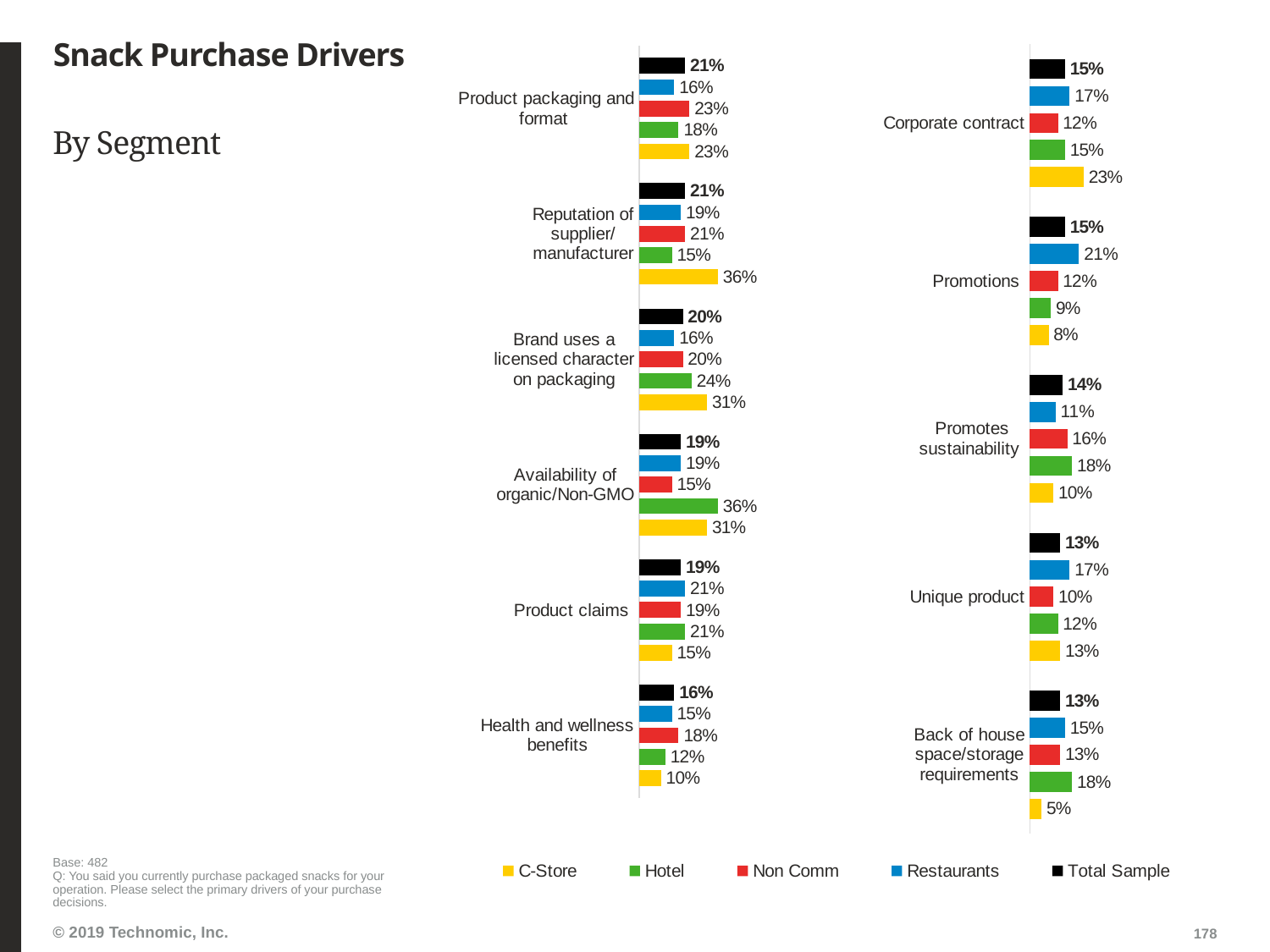
In the right chart, which is larger for Promotes sustainability: the Hotel value or the Restaurants value? Hotel How many categories are shown in the left chart? 6 In the left chart, what is the difference between the C-Store and Hotel values for Brand uses a licensed character on packaging? 7% In the right chart, what is the Restaurants value for Promotions? 21% How many categories are shown in the right chart? 5 In the left chart, what is the Hotel value for Availability of organic/Non-GMO? 36% In the left chart, which segment has the lowest value for Health and wellness benefits? C-Store What type of chart is used on this slide? Bar chart In the left chart, what is the C-Store value for Reputation of supplier/manufacturer? 36% How many series does the legend list? 5 In the right chart, what is the C-Store value for Back of house space/storage requirements? 5% In the right chart, which segment has the highest value for Corporate contract? C-Store